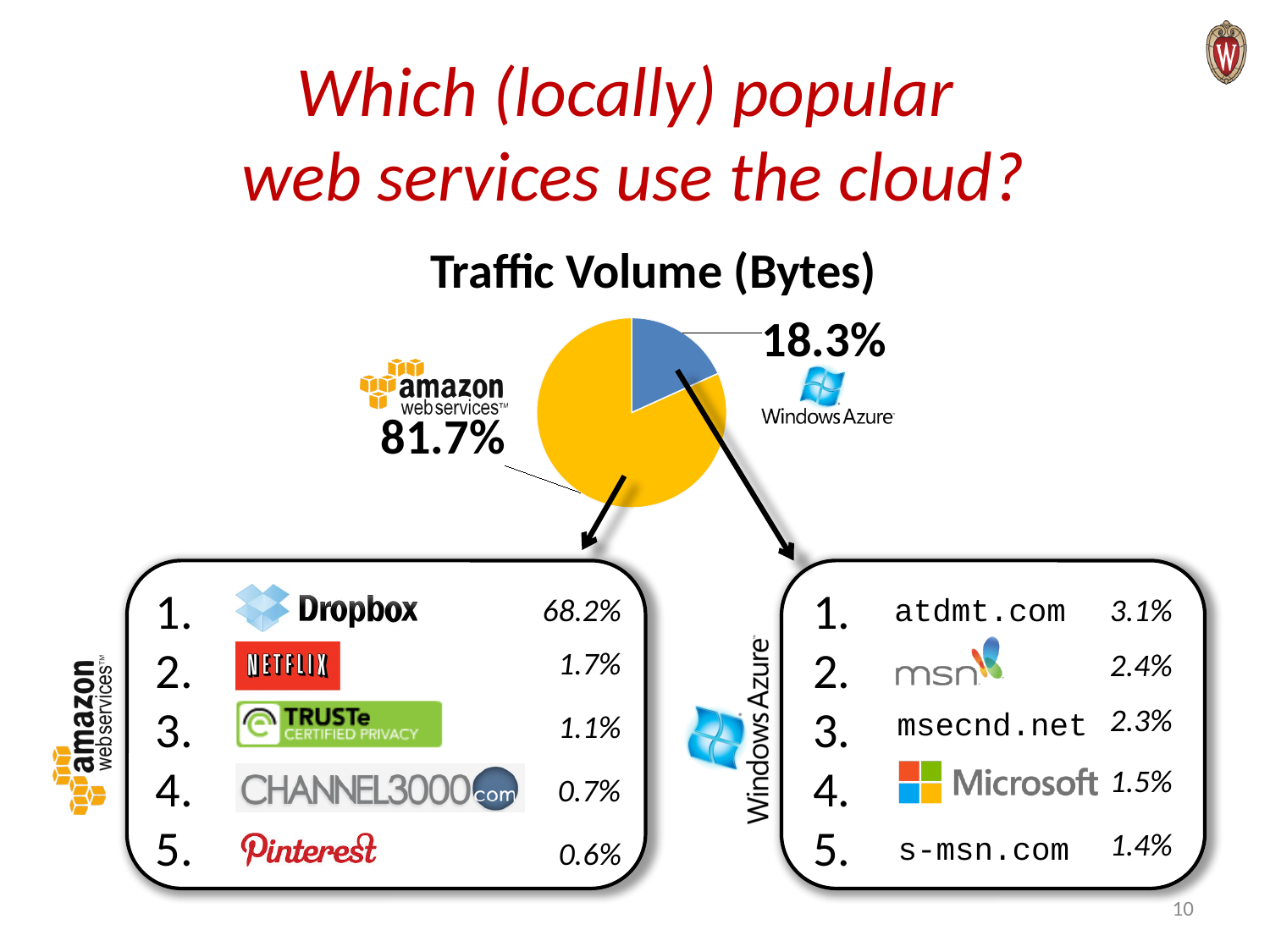
What share of traffic volume does Amazon Web Services account for in the pie chart? 81.7% In the Amazon Web Services breakdown list below the pie chart, what percentage is shown for Dropbox? 68.2% Which slice of the pie chart is the smallest? Windows Azure Which is larger in the pie chart, the Amazon Web Services share or the Windows Azure share? Amazon Web Services How many slices does the pie chart have? 2 What is the difference in percentage points between the Amazon Web Services slice and the Windows Azure slice? 63.4 What type of chart is shown under the title "Traffic Volume (Bytes)"? pie chart What is the title of the pie chart? Traffic Volume (Bytes) What colour is the Windows Azure slice in the pie chart? blue Which slice of the pie chart is the largest? Amazon Web Services In the Windows Azure breakdown list below the pie chart, what percentage is shown for atdmt.com? 3.1% What share of traffic volume does Windows Azure account for in the pie chart? 18.3%